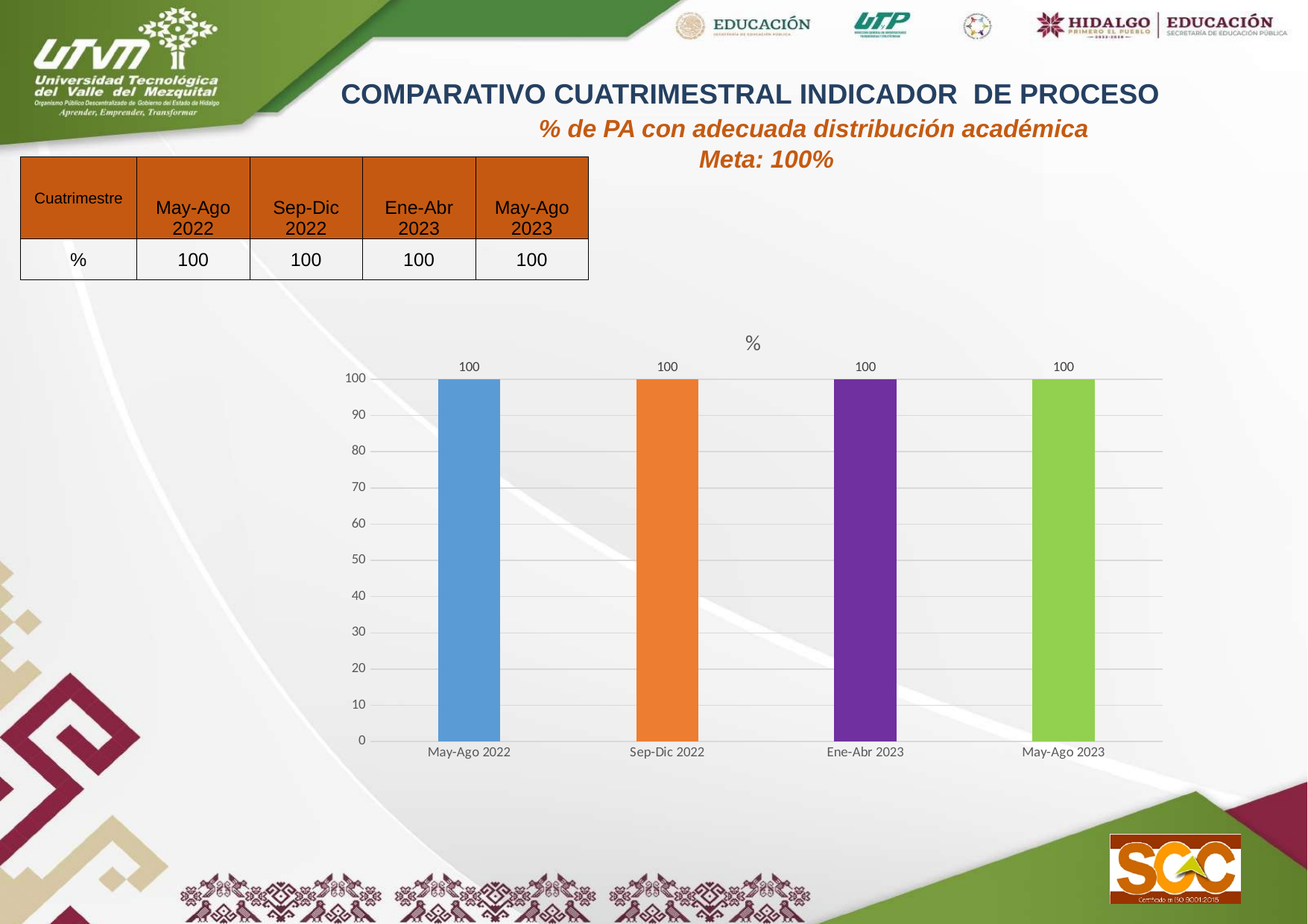
What is the value for May-Ago 2023? 100 What kind of chart is shown on the slide? bar chart What is the highest tick value shown on the y axis? 100 Do the values rise, fall, or stay the same across the cuatrimestres from May-Ago 2022 to May-Ago 2023? stay the same What colour is the bar for Sep-Dic 2022? orange What is the value for Ene-Abr 2023? 100 How many categories are shown on the x axis of the chart? 4 Is the value for Ene-Abr 2023 greater or less than 90? greater What is the value for Sep-Dic 2022? 100 What is the difference between the values for May-Ago 2022 and May-Ago 2023? 0 What is the title of the chart? % What is the value for May-Ago 2022? 100